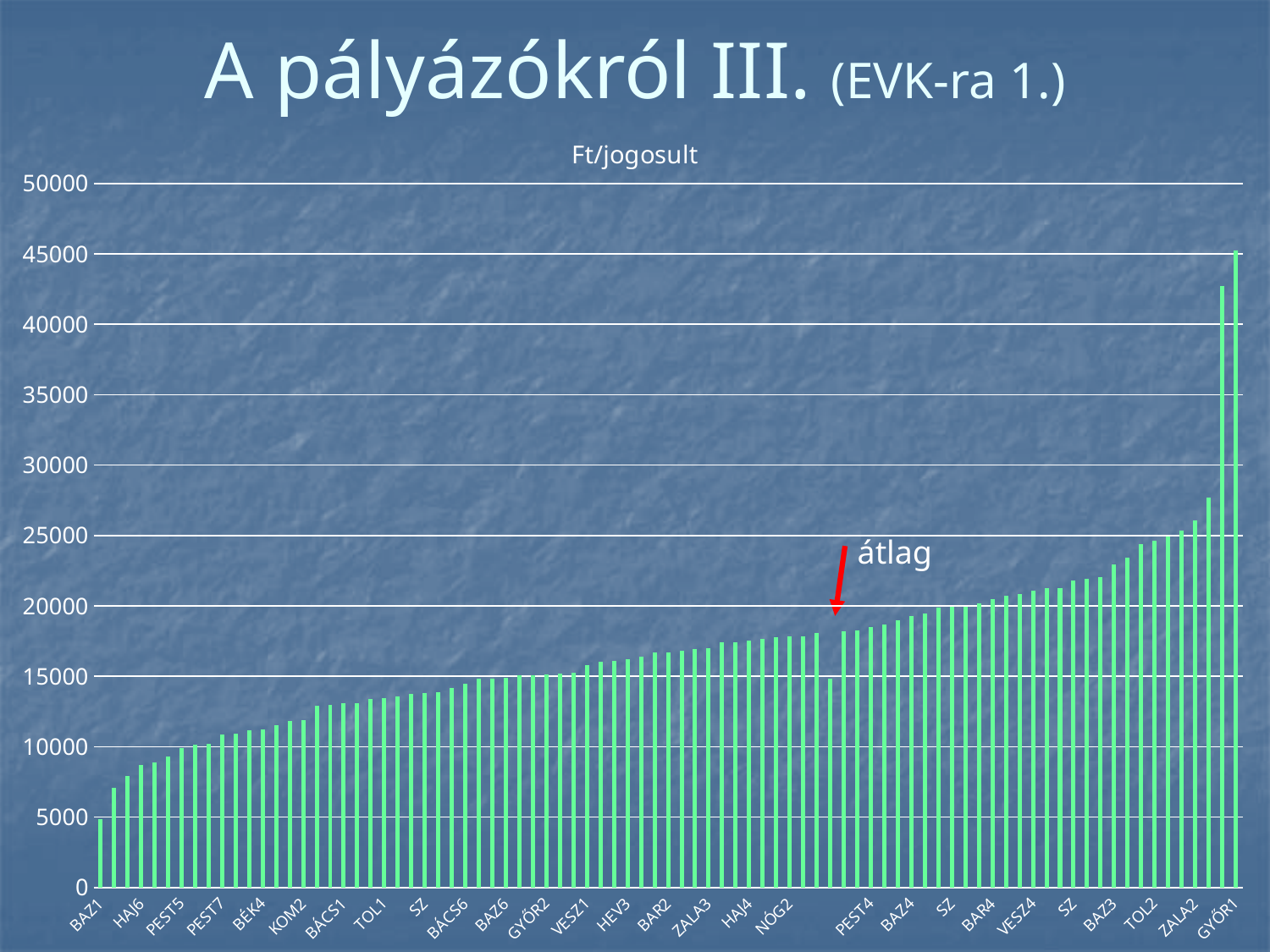
Which is larger, the value for GYŐR1 or the value for BAZ1? GYŐR1 What is the title of the chart? Ft/jogosult What kind of chart is shown on the slide? bar chart Which category has the highest value? GYŐR1 Is the value for BAZ1 greater or less than 10000? less Is the value for GYŐR1 greater or less than 40000? greater Do the values rise or fall from left to right along the x axis? rise Which category has the lowest value? BAZ1 Is the value for NÓG2 greater or less than 20000? less What word does the red arrow annotation on the chart point to? átlag